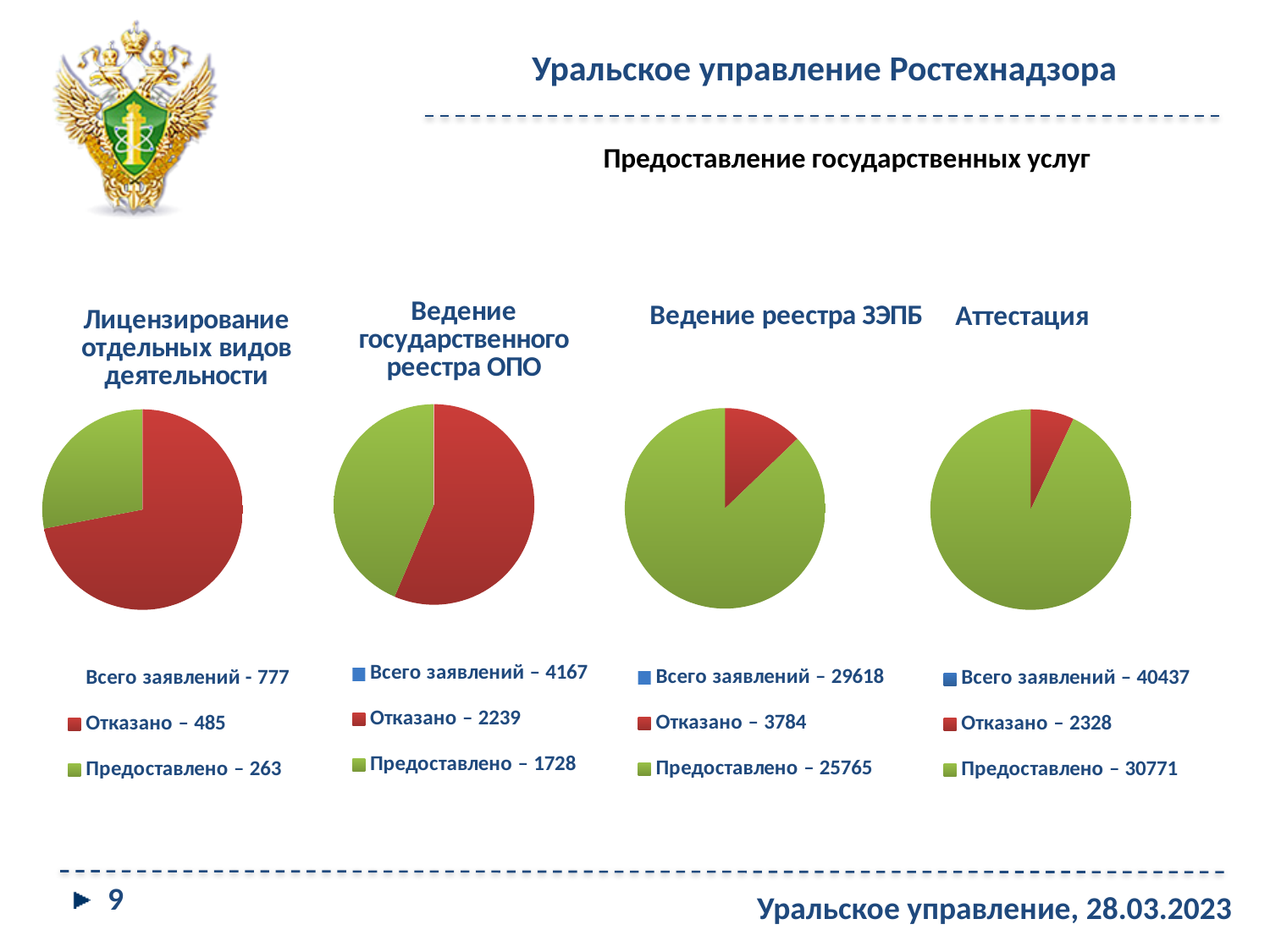
In the 'Аттестация' chart, which slice is larger, 'Отказано' or 'Предоставлено'? Предоставлено What kind of chart is used for 'Аттестация'? Pie chart In the 'Ведение государственного реестра ОПО' chart, what is the value for 'Отказано'? 2239 In the 'Ведение государственного реестра ОПО' chart, what colour represents 'Предоставлено'? Green In the 'Лицензирование отдельных видов деятельности' chart, what is the value for 'Отказано'? 485 In the 'Лицензирование отдельных видов деятельности' chart, which slice is larger, 'Отказано' or 'Предоставлено'? Отказано In the 'Ведение реестра ЗЭПБ' chart, what is the difference between 'Предоставлено' and 'Отказано'? 21981 How many slices does the 'Ведение реестра ЗЭПБ' pie chart have? 2 In the 'Ведение государственного реестра ОПО' chart, what is the difference between 'Отказано' and 'Предоставлено'? 511 In the 'Лицензирование отдельных видов деятельности' chart, what is the value for 'Предоставлено'? 263 In the 'Ведение реестра ЗЭПБ' chart, what is the value for 'Предоставлено'? 25765 In the 'Аттестация' chart, what is the value for 'Отказано'? 2328